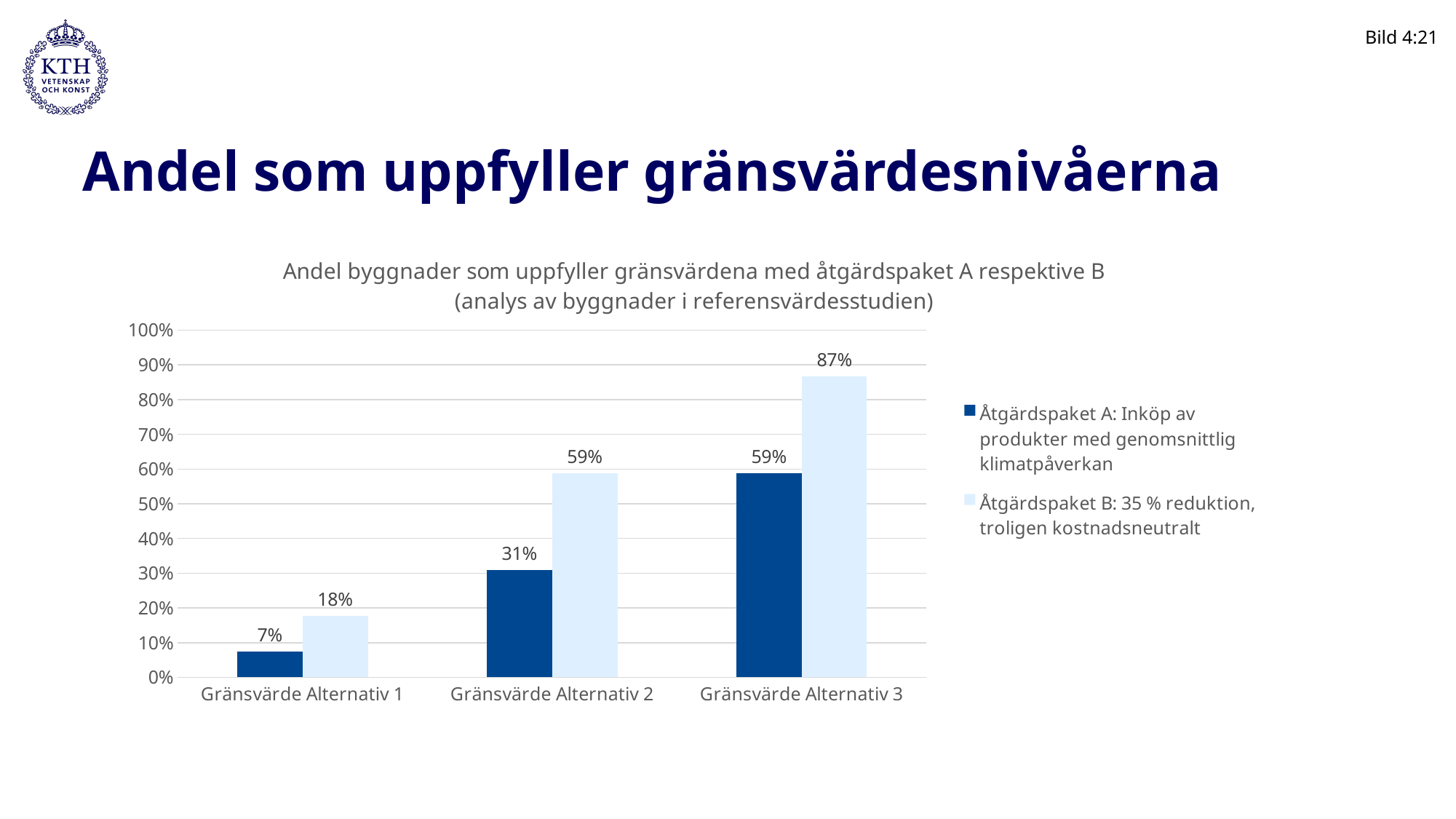
How many series does the legend list? 2 How many categories are shown on the x axis? 3 What is the value for Åtgärdspaket A at Gränsvärde Alternativ 2? 31% What is the value for Åtgärdspaket B at Gränsvärde Alternativ 1? 18% What is the difference between Åtgärdspaket B and Åtgärdspaket A at Gränsvärde Alternativ 3? 28% What is the value for Åtgärdspaket A at Gränsvärde Alternativ 1? 7% Which category has the highest value for Åtgärdspaket B? Gränsvärde Alternativ 3 Which is larger at Gränsvärde Alternativ 2: Åtgärdspaket A or Åtgärdspaket B? Åtgärdspaket B What is the value for Åtgärdspaket B at Gränsvärde Alternativ 3? 87% What kind of chart is shown on the slide? Bar chart Which category has the lowest value for Åtgärdspaket A? Gränsvärde Alternativ 1 Do the values for Åtgärdspaket A rise or fall from Gränsvärde Alternativ 1 to Gränsvärde Alternativ 3? Rise